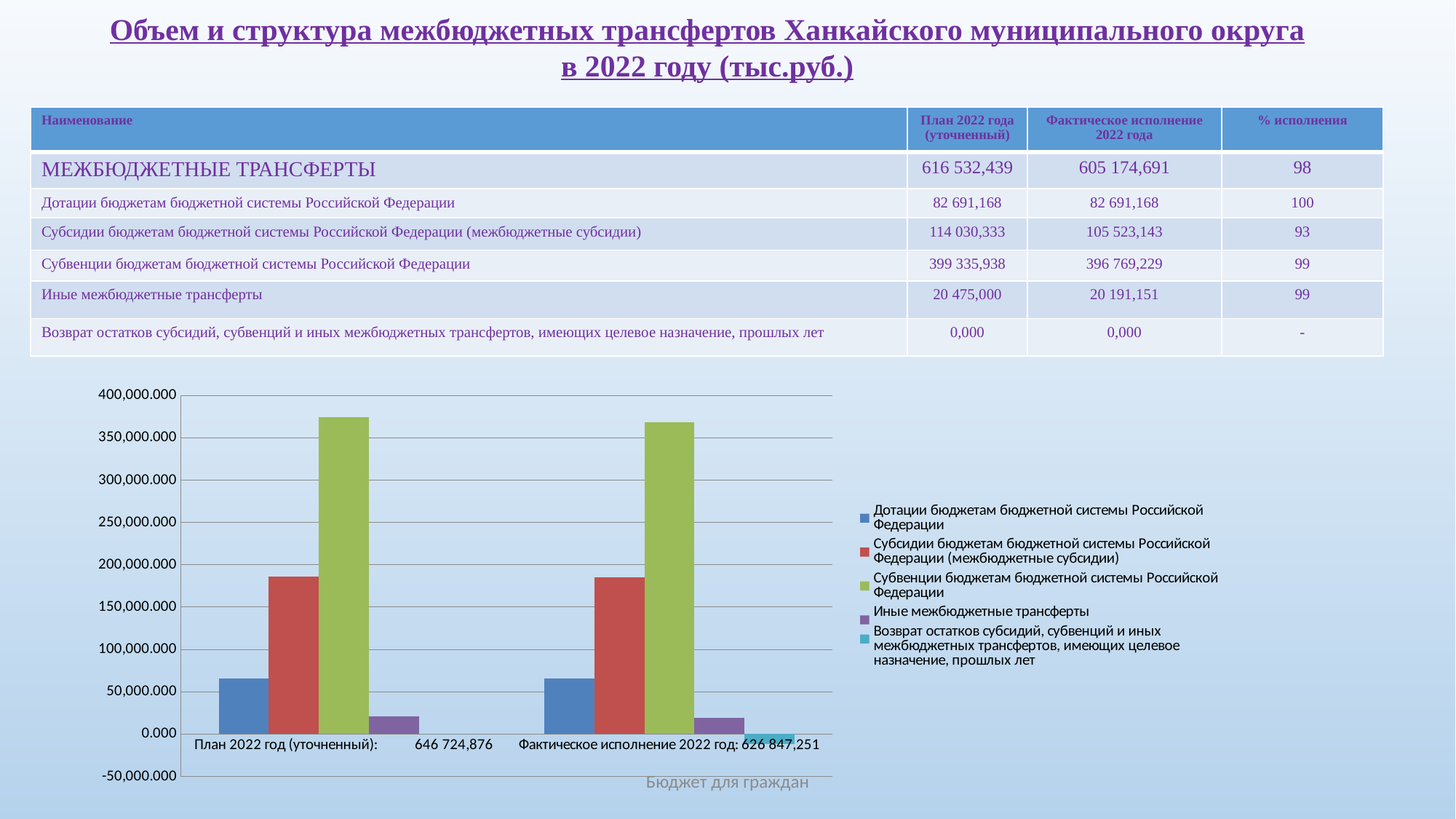
How many categories are shown on the x axis of the chart? 2 Is the value for Субвенции in the 'План 2022 год (уточненный)' group greater or less than 350,000.000? greater Is the value for Дотации in the 'План 2022 год (уточненный)' group greater or less than 100,000.000? less Is the value for Иные межбюджетные трансферты in the 'Фактическое исполнение 2022 год' group greater or less than 50,000.000? less What colour represents Субвенции бюджетам бюджетной системы Российской Федерации in the chart legend? green How many series does the chart legend list? 5 Which series has the lowest bar in the 'Фактическое исполнение 2022 год' group? Возврат остатков субсидий, субвенций и иных межбюджетных трансфертов, имеющих целевое назначение, прошлых лет Which series has the tallest bar in the 'Фактическое исполнение 2022 год' group? Субвенции бюджетам бюджетной системы Российской Федерации What kind of chart is shown on the slide? bar chart Which series has the tallest bar in the 'План 2022 год (уточненный)' group? Субвенции бюджетам бюджетной системы Российской Федерации In the 'План 2022 год (уточненный)' group, which is larger: the bar for Субсидии or the bar for Дотации? Субсидии